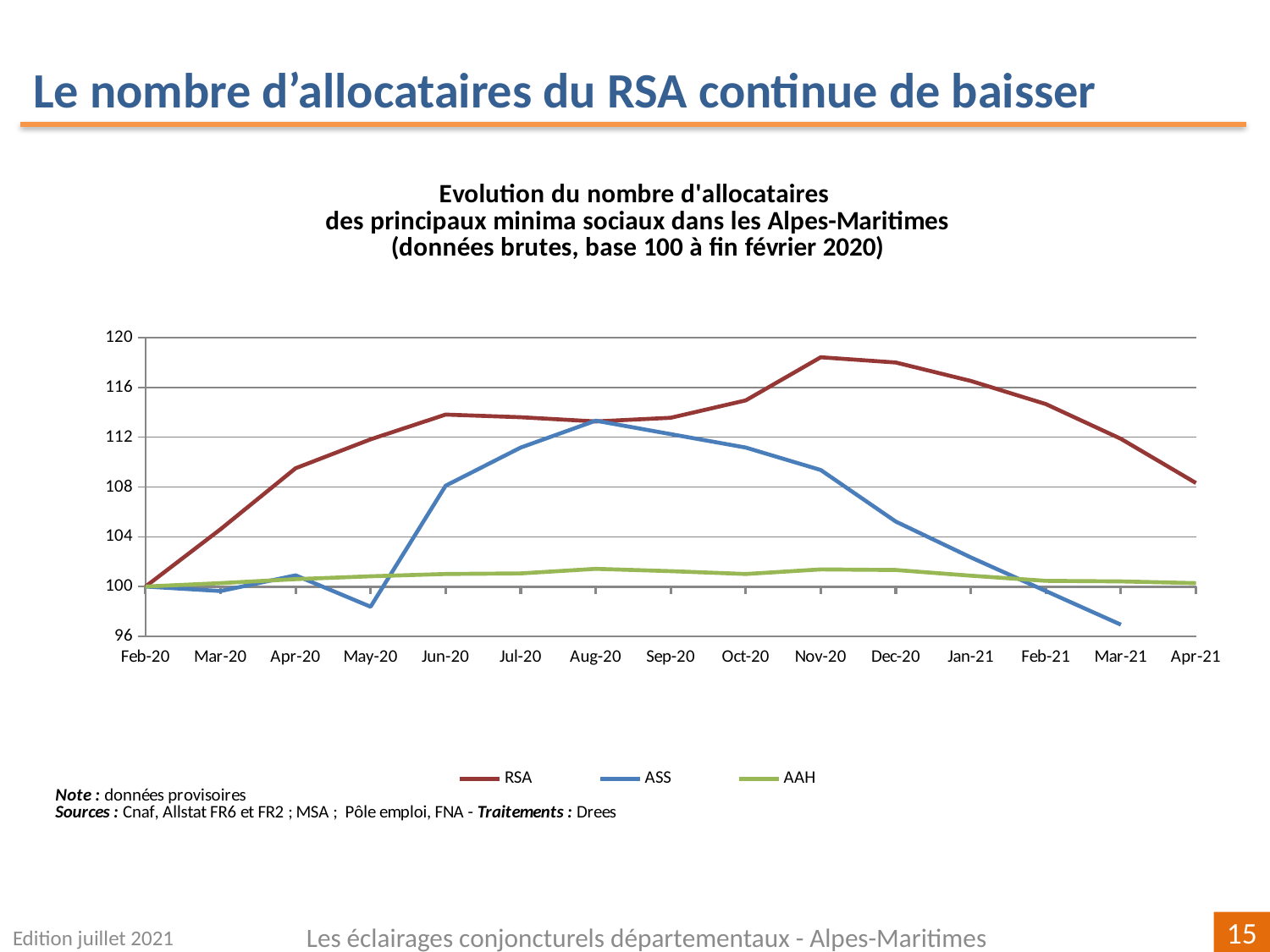
What is the value of the RSA series at Feb-20? 100 How many series does the legend list? 3 Is the value for RSA at Apr-21 greater or less than 112? less Which is larger at Dec-20, the RSA value or the ASS value? RSA How many months are shown along the x axis? 15 What kind of chart is shown on the slide? Line chart Is the value for ASS at Mar-21 greater or less than 100? less In which month does the ASS series reach its lowest value? Mar-21 Which series has the highest value at Nov-20? RSA Which series is drawn in green? AAH Does the RSA series rise or fall between Nov-20 and Apr-21? Fall Is the value for RSA at Nov-20 greater or less than 116? greater